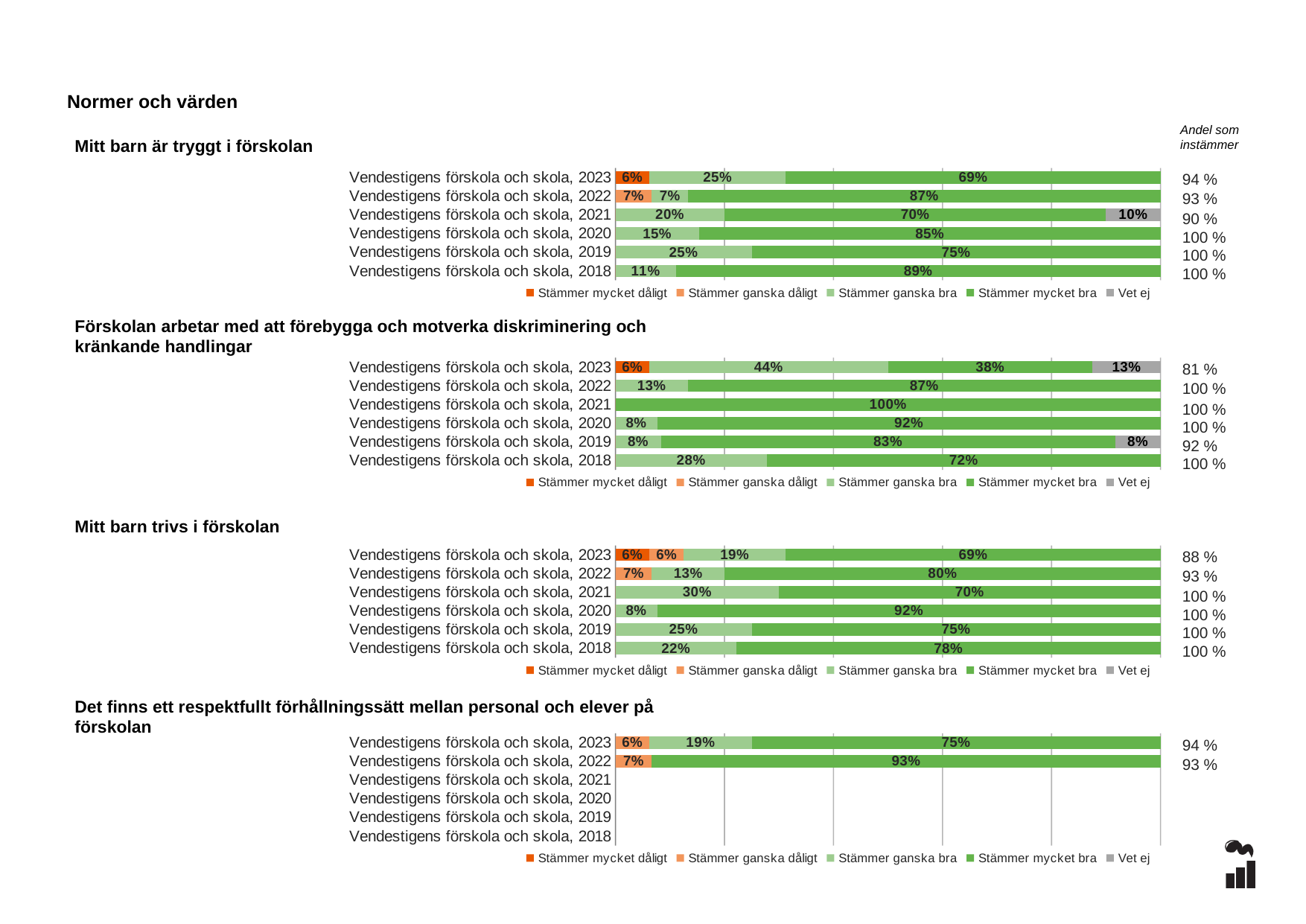
What kind of chart is "Förskolan arbetar med att förebygga och motverka diskriminering och kränkande handlingar"? Stacked bar chart In the chart "Mitt barn är tryggt i förskolan", what is the value for "Stämmer mycket bra" for Vendestigens förskola och skola, 2022? 87% How many year categories are listed on the y axis of the chart "Mitt barn är tryggt i förskolan"? 6 In the chart "Mitt barn trivs i förskolan", what is the difference between the "Stämmer mycket bra" values for 2020 and 2021? 22% In the chart "Förskolan arbetar med att förebygga och motverka diskriminering och kränkande handlingar", which year has the highest "Stämmer mycket bra" value? Vendestigens förskola och skola, 2021 In the chart "Mitt barn trivs i förskolan", which year has the lowest "Stämmer mycket bra" value? Vendestigens förskola och skola, 2023 In the chart "Mitt barn är tryggt i förskolan", what is the "Vet ej" value for Vendestigens förskola och skola, 2021? 10% In the chart "Mitt barn är tryggt i förskolan", which is larger: the "Stämmer ganska bra" value for 2019 or for 2020? 2019 In the chart "Det finns ett respektfullt förhållningssätt mellan personal och elever på förskolan", how many years have bars plotted? 2 How many series does the legend list in the chart "Mitt barn trivs i förskolan"? 5 In the chart "Förskolan arbetar med att förebygga och motverka diskriminering och kränkande handlingar", what is the value for "Stämmer ganska bra" for Vendestigens förskola och skola, 2023? 44% In the chart "Det finns ett respektfullt förhållningssätt mellan personal och elever på förskolan", what is the "Stämmer mycket bra" value for Vendestigens förskola och skola, 2022? 93%